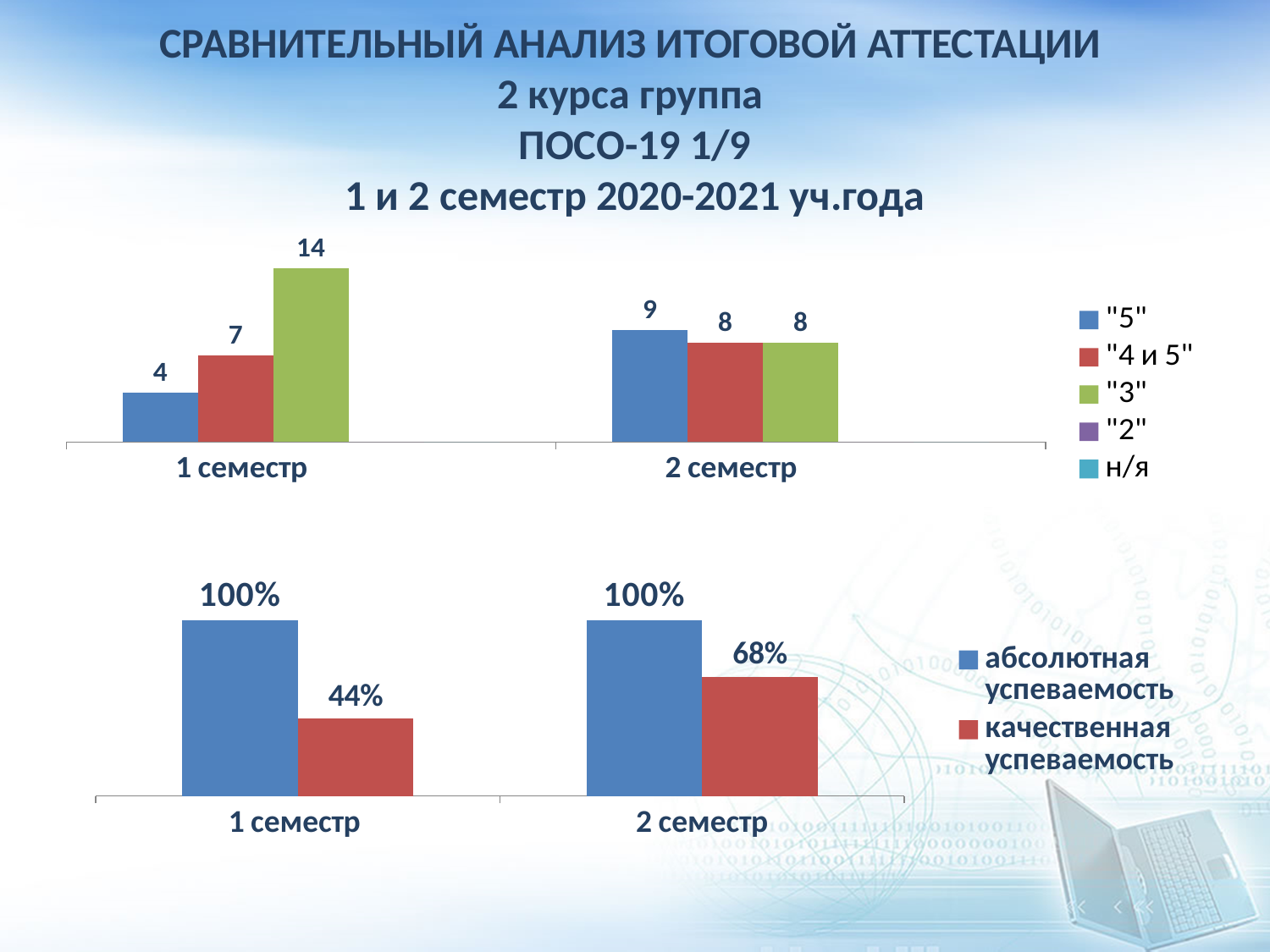
In the top chart, what is the difference between the "3" value in 1 семестр and the "3" value in 2 семестр? 6 In the top chart, what is the value for "3" in 1 семестр? 14 In the top chart, what is the value for "4 и 5" in 1 семестр? 7 In the top chart, what is the value for "5" in 2 семестр? 9 What type of chart is the bottom chart? bar chart In the top chart, is the value for "5" larger in 1 семестр or in 2 семестр? 2 семестр In the bottom chart, does качественная успеваемость rise or fall from 1 семестр to 2 семестр? rise In the top chart, which series has the highest value in 1 семестр? "3" In the bottom chart, what is the value for качественная успеваемость in 2 семестр? 68% In the bottom chart, what is the difference between качественная успеваемость in 2 семестр and in 1 семестр? 24% In the top chart, how many series does the legend list? 5